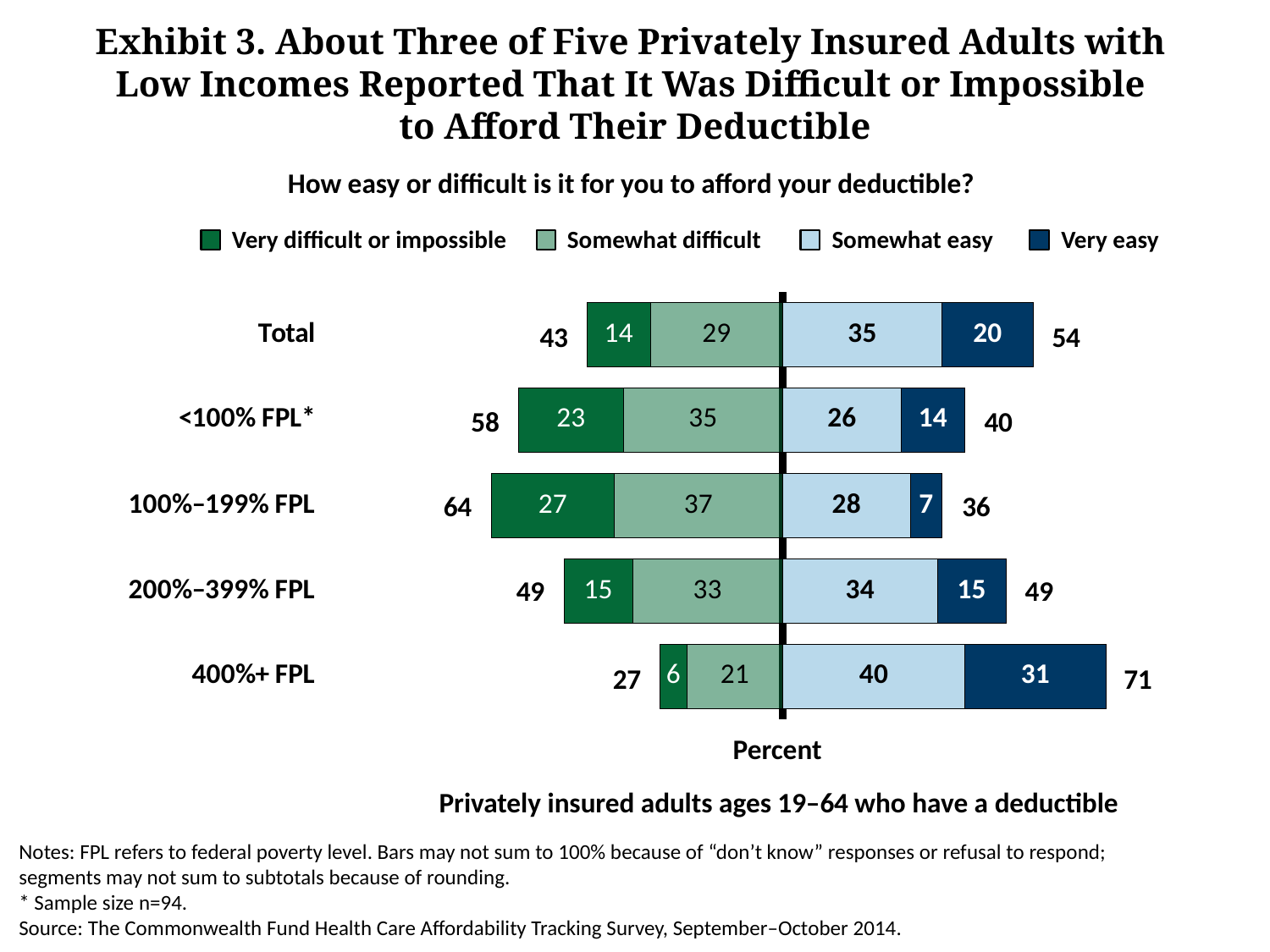
What is the combined 'difficult' subtotal (very difficult or impossible plus somewhat difficult) shown for the 200%–399% FPL group? 49 What is the 'Somewhat easy' value for the Total bar? 35 Which is larger: the 'Somewhat easy' value for 200%–399% FPL or for <100% FPL? 200%–399% FPL What is the label on the horizontal axis of the chart? Percent Which income group has the highest 'Very difficult or impossible' value? 100%–199% FPL What percentage of adults with incomes of 100%–199% FPL said it was very difficult or impossible to afford their deductible? 27 What is the 'Very easy' value for the 400%+ FPL group? 31 What is the difference between the 'Somewhat difficult' values for the <100% FPL group and the 400%+ FPL group? 14 What kind of chart is shown on the slide? Stacked bar chart Which income group has the lowest 'Very easy' value? 100%–199% FPL How many income categories are shown on the chart? 5 How many series does the legend list? 4